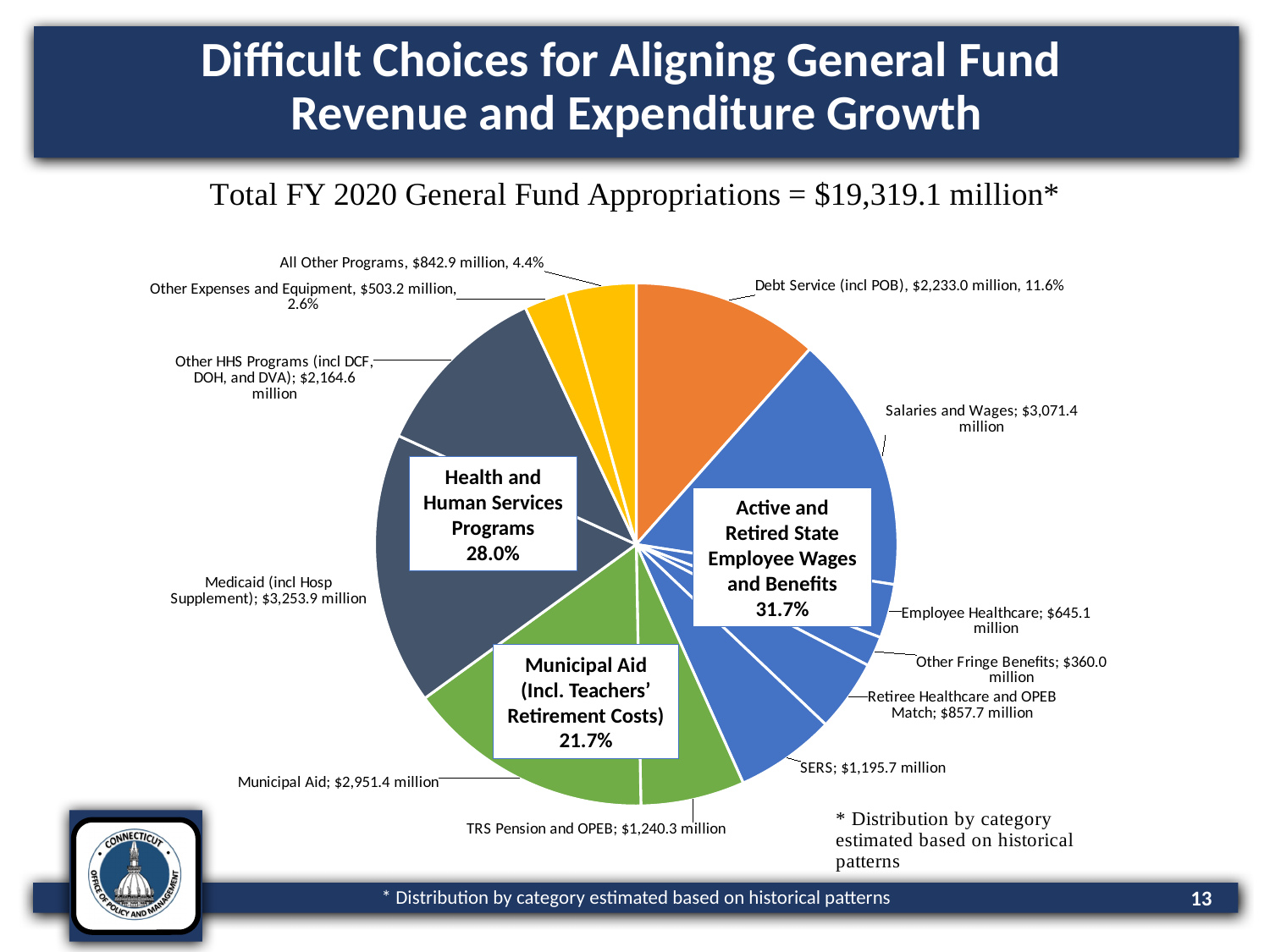
What type of chart is shown on the slide? Pie chart Which slice has the smallest value? Other Fringe Benefits What is the value for SERS? $1,195.7 million What is the total FY 2020 General Fund Appropriations stated above the chart? $19,319.1 million How many slices does the pie chart have? 12 Which is larger, Retiree Healthcare and OPEB Match or Employee Healthcare? Retiree Healthcare and OPEB Match What percentage share does All Other Programs represent? 4.4% What is the value for Medicaid (incl Hosp Supplement)? $3,253.9 million What is the value for Salaries and Wages? $3,071.4 million What percentage share does Debt Service (incl POB) represent? 11.6% What is the difference between Municipal Aid and TRS Pension and OPEB? $1,711.1 million Which slice has the largest value? Medicaid (incl Hosp Supplement)